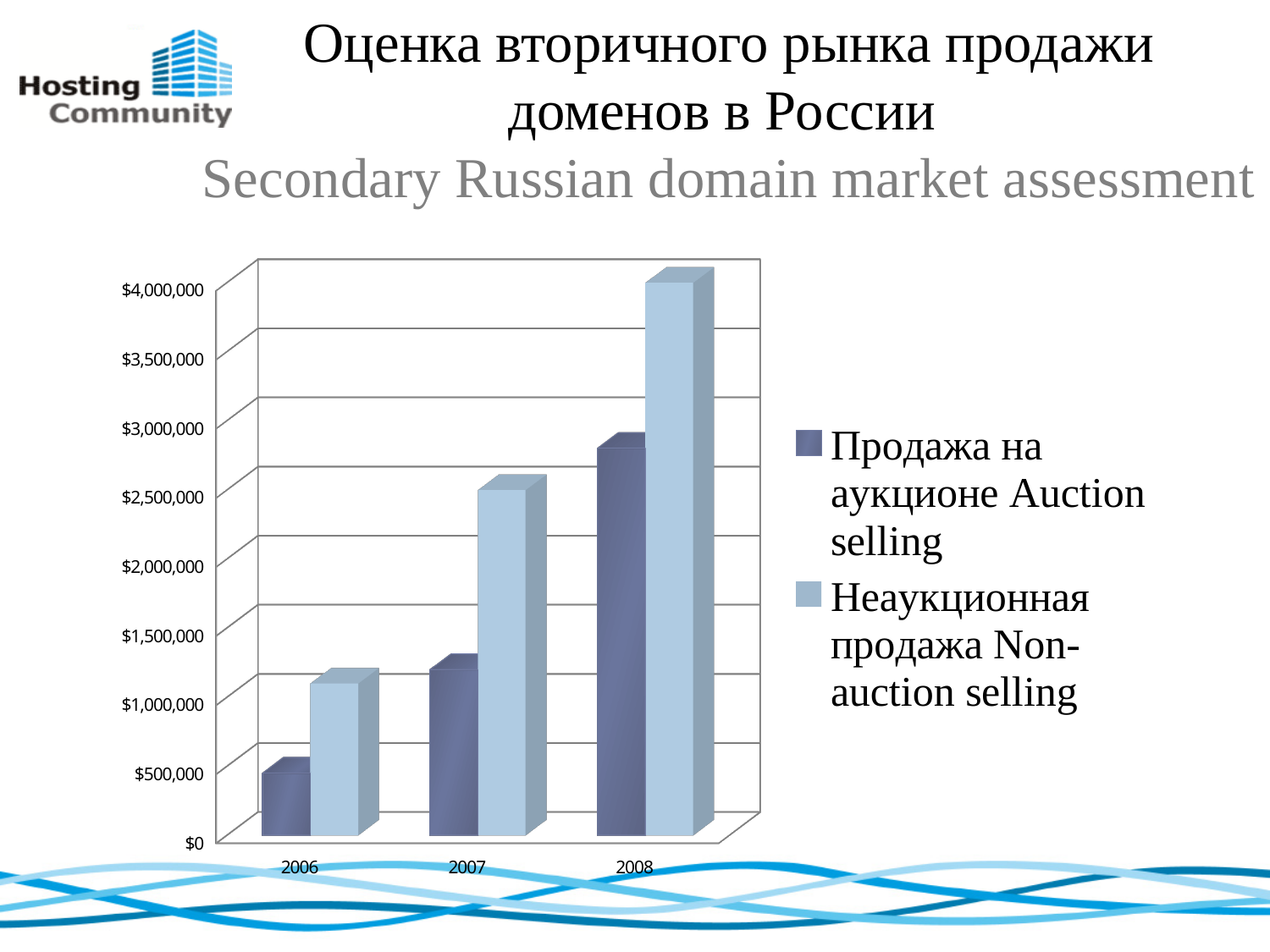
How many years are shown on the x axis? 3 Is the Non-auction selling value for 2008 greater or less than $3,500,000? greater Is the Non-auction selling value for 2007 greater or less than $2,000,000? greater Is the Auction selling value for 2006 greater or less than $1,000,000? less What kind of chart is shown on the slide? bar chart Do the Auction selling values rise or fall from 2006 to 2008? rise How many series does the legend list? 2 Which year has the lowest Auction selling value? 2006 Which year has the highest Non-auction selling value? 2008 In 2008, which is larger: Auction selling or Non-auction selling? Non-auction selling Which series is shown in the darker blue bars? Продажа на аукционе Auction selling